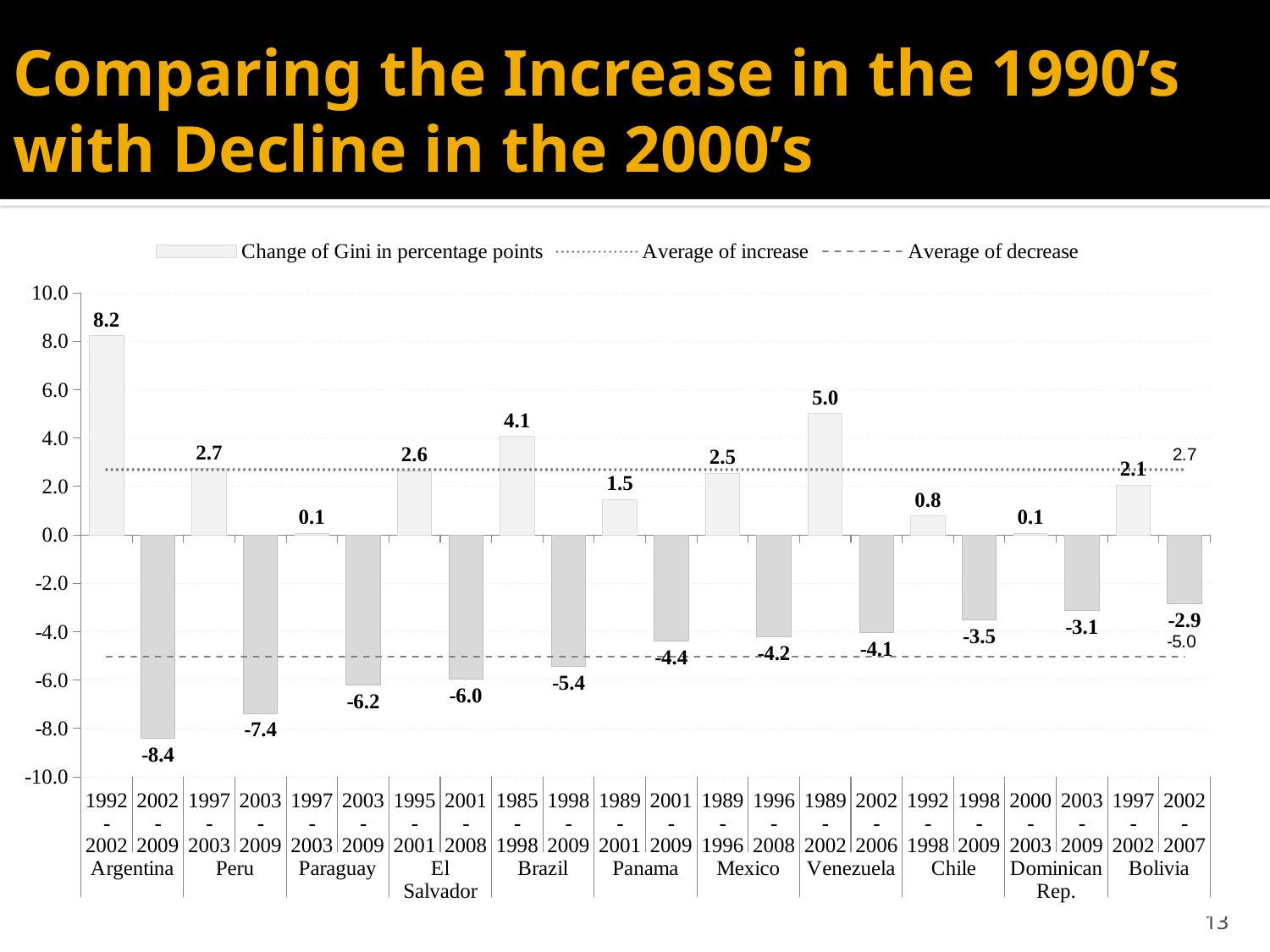
Which country and period has the highest change of Gini in percentage points? Argentina, 1992-2002 How many entries does the chart legend list? 3 What is the change of Gini in percentage points for Venezuela in 1989-2002? 5.0 What is the change of Gini in percentage points for Argentina in 1992-2002? 8.2 What value is labelled for the average of increase line? 2.7 What is the change of Gini in percentage points for Brazil in 1998-2009? -5.4 What kind of chart is shown on the slide? Bar chart with two horizontal average lines (combination bar and line chart) How many countries are shown on the x axis of the chart? 11 Which country and period has the lowest change of Gini in percentage points? Argentina, 2002-2009 What value is labelled for the average of decrease line? -5.0 What is the difference between the change of Gini for Peru in 1997-2003 and for Peru in 2003-2009? 10.1 Which is larger, the change of Gini for Brazil in 1985-1998 or for Mexico in 1989-1996? Brazil in 1985-1998